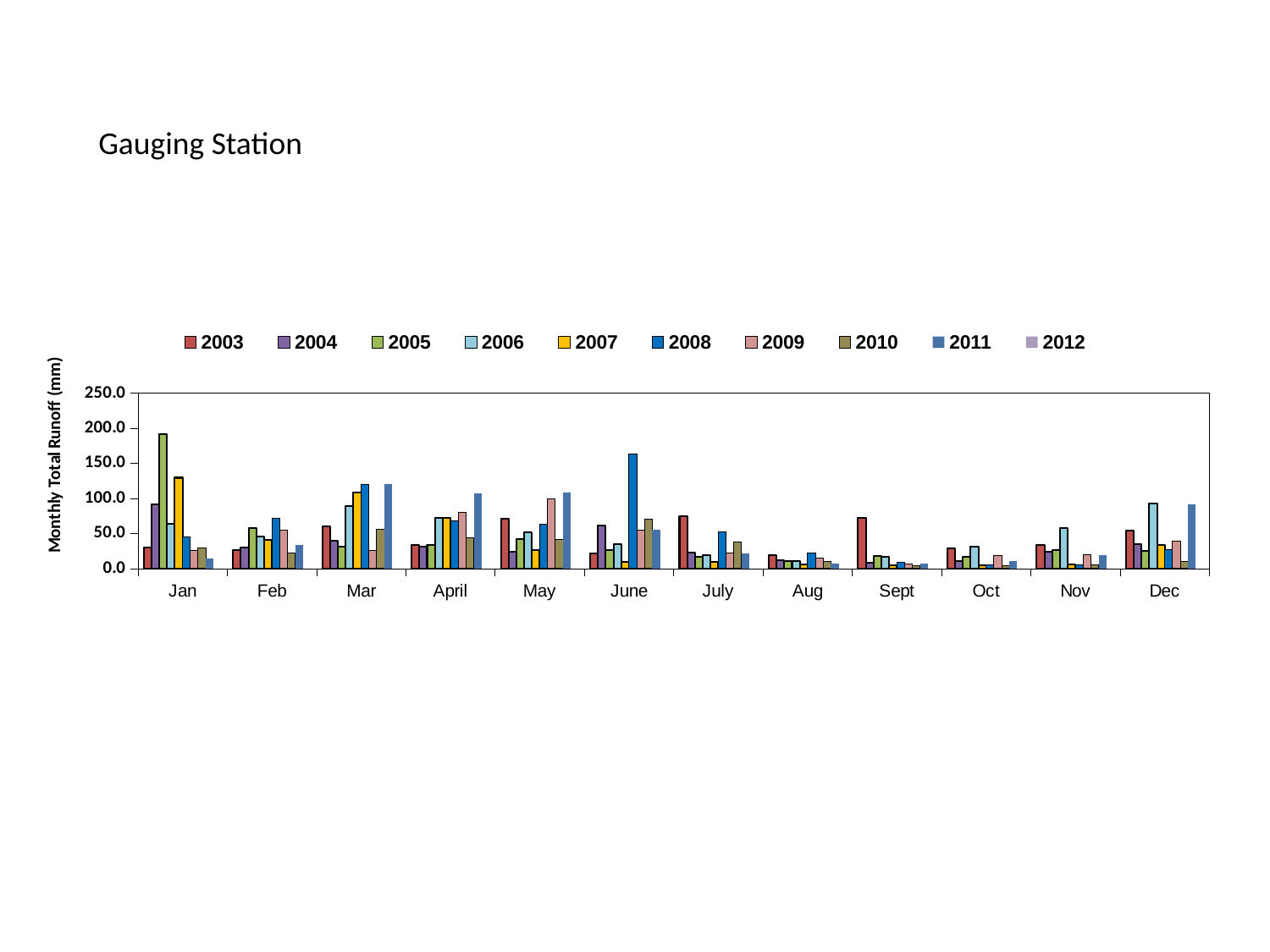
What is the label on the vertical axis? Monthly Total Runoff (mm) Which is larger: the 2003 bar in Sept or the 2003 bar in Aug? 2003 in Sept What kind of chart is shown on the slide? bar chart Which year has the highest bar in Sept? 2003 Is the value for 2008 in June greater or less than 150.0? greater How many series does the legend list? 10 Which year has the highest bar in Jan? 2005 How many months (categories) are shown along the x axis? 12 Is the value for 2008 in Aug greater or less than 50.0? less Is the value for 2005 in Jan greater or less than 150.0? greater Which year has the highest bar in June? 2008 Which is larger: the 2005 bar in Jan or the 2007 bar in Jan? 2005 in Jan